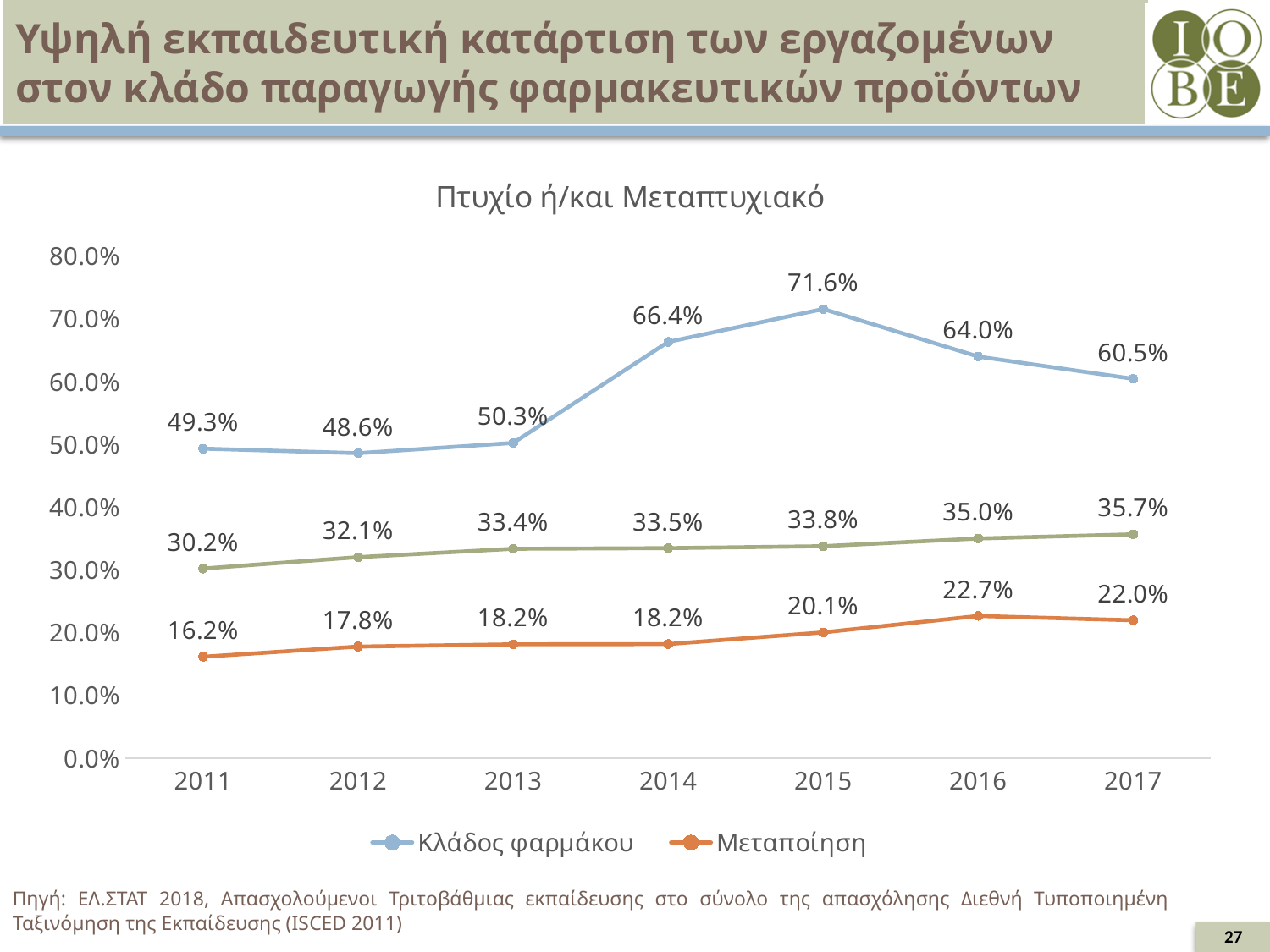
Which is larger in 2016: Κλάδος φαρμάκου or Μεταποίηση? Κλάδος φαρμάκου What is the title of the chart? Πτυχίο ή/και Μεταπτυχιακό In which year does Κλάδος φαρμάκου reach its highest value? 2015 What is the value for Κλάδος φαρμάκου in 2015? 71.6% What is the value for Κλάδος φαρμάκου in 2017? 60.5% How many series does the legend list? 2 What is the difference between Κλάδος φαρμάκου and Μεταποίηση in 2014? 48.2% What is the value for Μεταποίηση in 2011? 16.2% What kind of chart is shown on the slide? Line chart In which year is the value for Κλάδος φαρμάκου lowest? 2012 In which year is the value for Μεταποίηση highest? 2016 How many years are shown on the x axis? 7